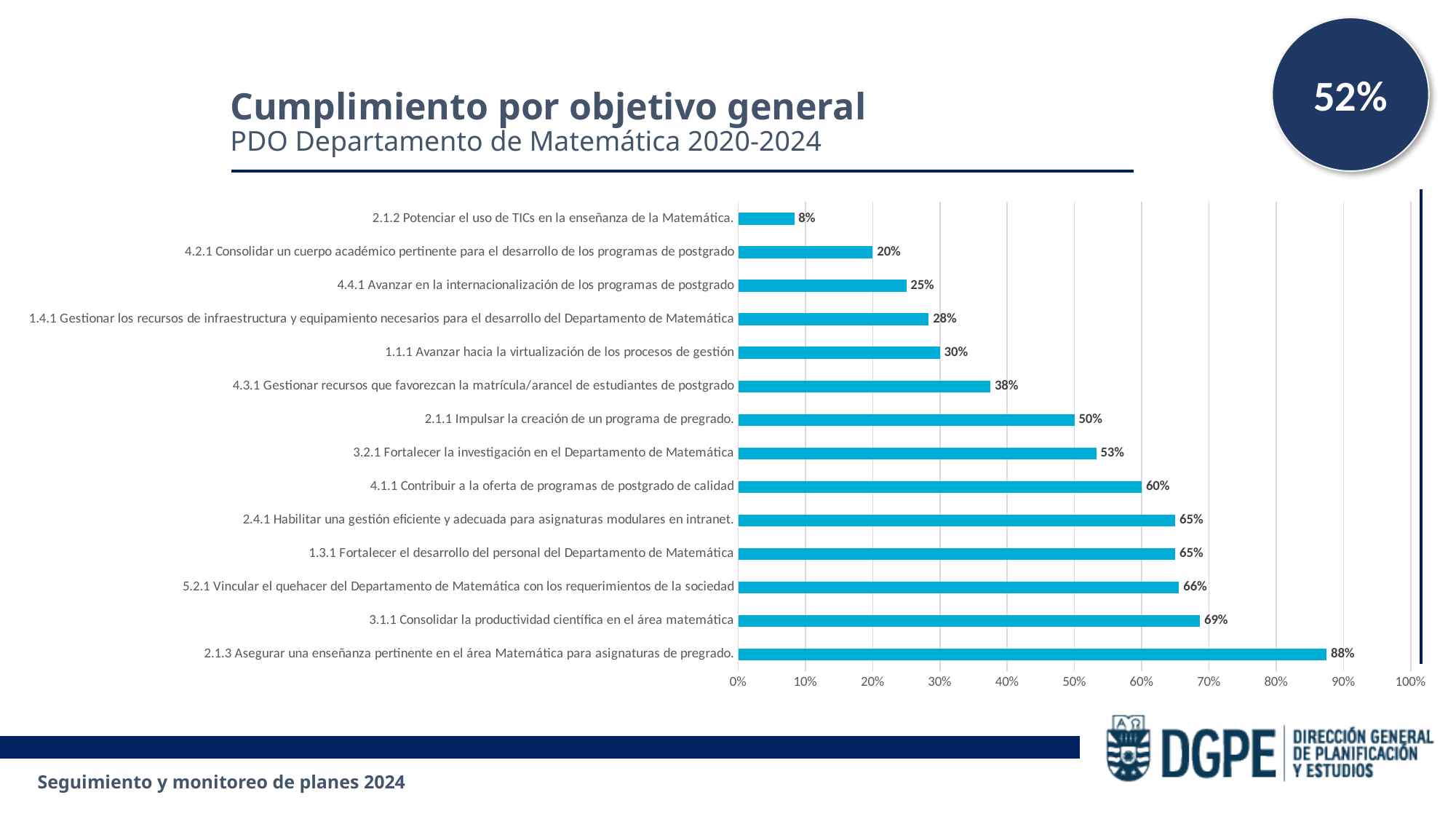
Which objective has the lowest value in the chart? 2.1.2 Potenciar el uso de TICs en la enseñanza de la Matemática. What is the value for objective 4.3.1 Gestionar recursos que favorezcan la matrícula/arancel de estudiantes de postgrado? 38% Which objective has the highest value in the chart? 2.1.3 Asegurar una enseñanza pertinente en el área Matemática para asignaturas de pregrado. What is the difference between the value for objective 2.1.3 and the value for objective 2.1.2? 80 percentage points How many objectives are plotted in the chart? 14 What percentage is shown in the circle at the top right of the slide? 52% Is the value for objective 4.1.1 Contribuir a la oferta de programas de postgrado de calidad greater or less than 50%? greater What is the title of the chart on the slide? Cumplimiento por objetivo general What is the value for objective 2.1.2 Potenciar el uso de TICs en la enseñanza de la Matemática? 8% What is the value for objective 3.2.1 Fortalecer la investigación en el Departamento de Matemática? 53% What kind of chart is shown on the slide? Bar chart Which has a larger value: objective 3.1.1 Consolidar la productividad científica en el área matemática or objective 5.2.1 Vincular el quehacer del Departamento de Matemática con los requerimientos de la sociedad? 3.1.1 Consolidar la productividad científica en el área matemática